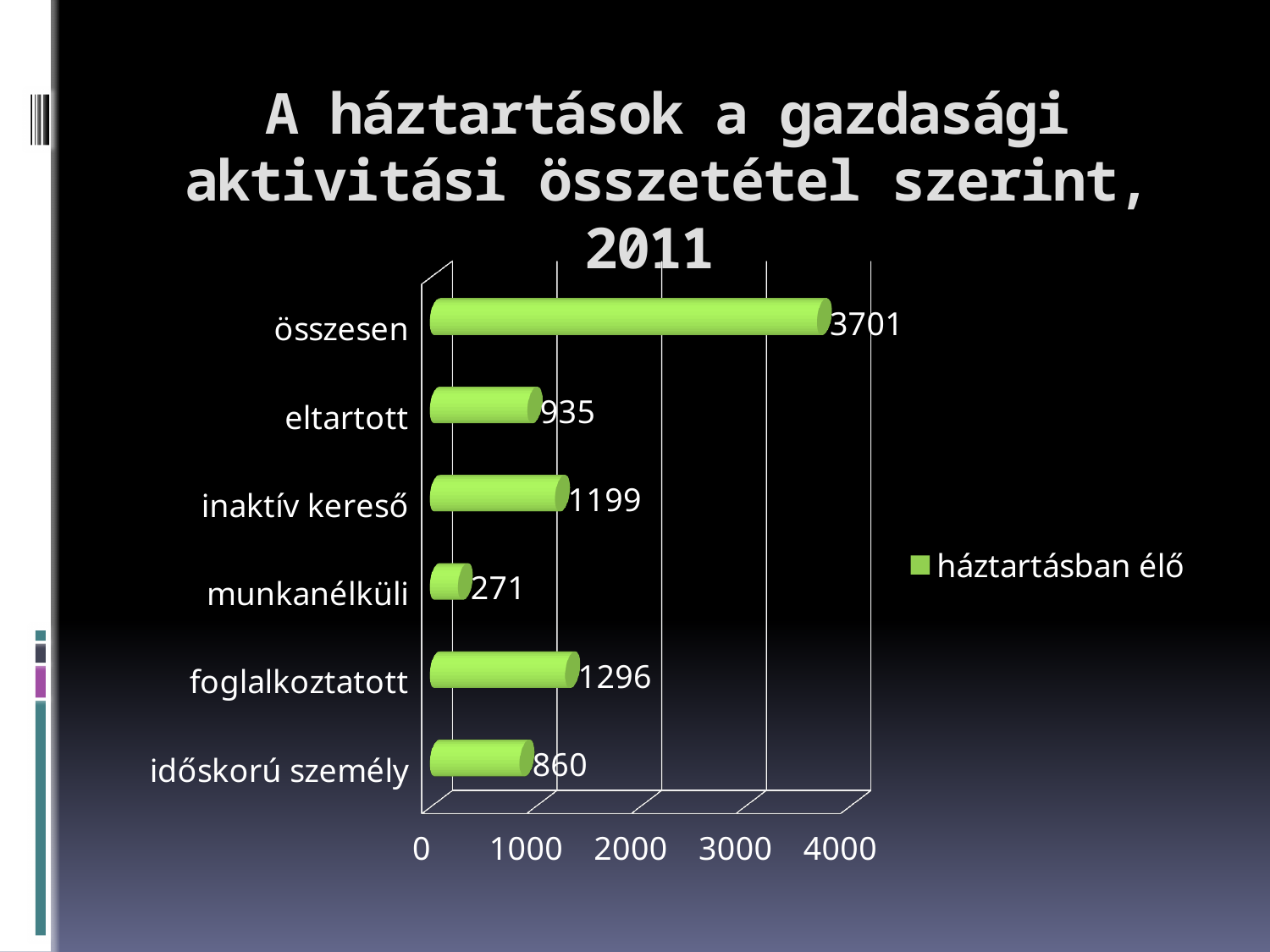
What is the difference between the values for foglalkoztatott and inaktív kereső? 97 How many categories are shown on the chart? 6 Which is larger, the value for eltartott or the value for időskorú személy? eltartott What is the value for munkanélküli? 271 Is the value for foglalkoztatott greater or less than 1000? greater What is the value for időskorú személy? 860 Which category has the highest value? összesen Which category has the lowest value? munkanélküli What kind of chart is shown on the slide? bar chart What is the value for összesen? 3701 What series name does the legend show? háztartásban élő What is the value for inaktív kereső? 1199